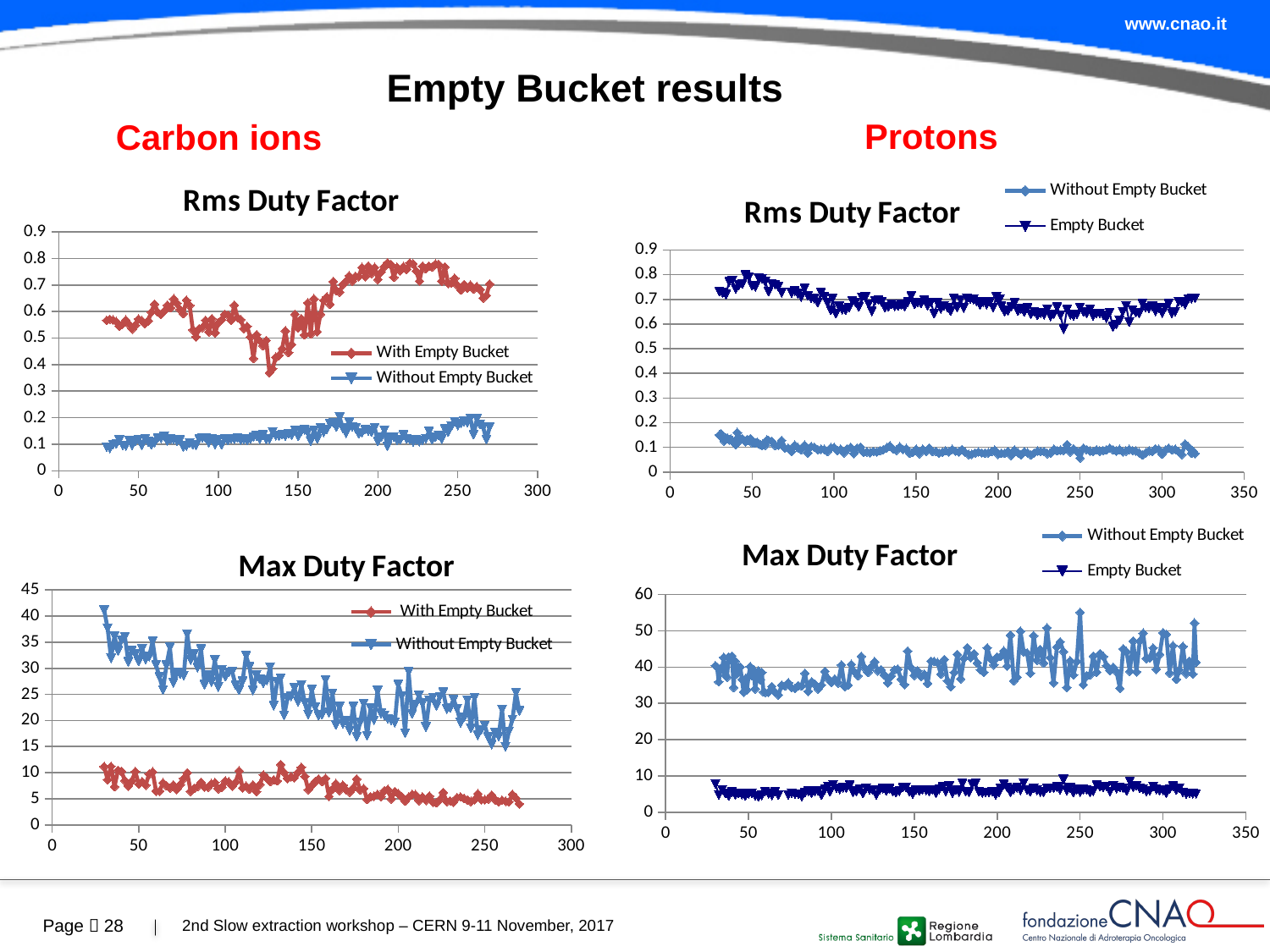
What kind of chart is the Protons Max Duty Factor chart? line chart In the Protons Max Duty Factor chart, are the values of the Without Empty Bucket series greater or less than 30? greater In the Protons Max Duty Factor chart, are the values of the Empty Bucket series greater or less than 20? less What are the two legend entries in the Protons Rms Duty Factor chart? Without Empty Bucket, Empty Bucket How many series does the legend list in the Carbon ions Rms Duty Factor chart? 2 In the Carbon ions Max Duty Factor chart, do the Without Empty Bucket values generally rise or fall along the x axis? fall In the Carbon ions Rms Duty Factor chart, which series has the higher values, With Empty Bucket or Without Empty Bucket? With Empty Bucket In the Carbon ions Rms Duty Factor chart, are the values of the Without Empty Bucket series greater or less than 0.3? less In the Protons Rms Duty Factor chart, which series has the higher values, Empty Bucket or Without Empty Bucket? Empty Bucket What is the highest tick shown on the y axis of the Carbon ions Max Duty Factor chart? 45